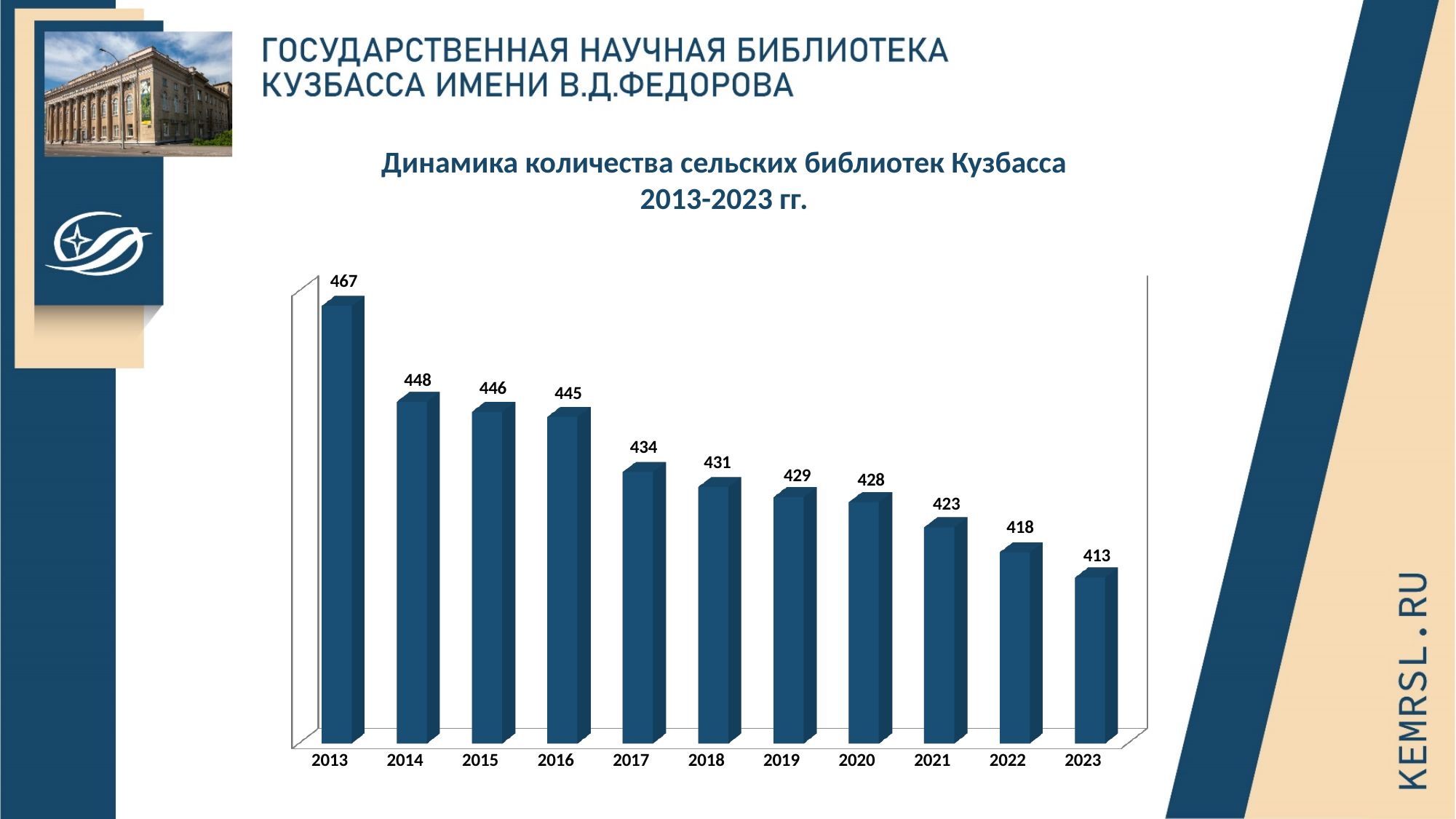
What is the difference between the values for 2016 and 2017? 11 Which year has the lowest value? 2023 What is the difference between the values for 2013 and 2023? 54 Which is larger, the value for 2014 or the value for 2018? 2014 What is the title of the chart? Динамика количества сельских библиотек Кузбасса 2013-2023 гг. What kind of chart is this? bar chart What is the value for 2013? 467 Do the values rise or fall from 2013 to 2023? fall What is the value for 2023? 413 What is the value for 2019? 429 How many years are shown on the x axis? 11 Which year has the highest value? 2013